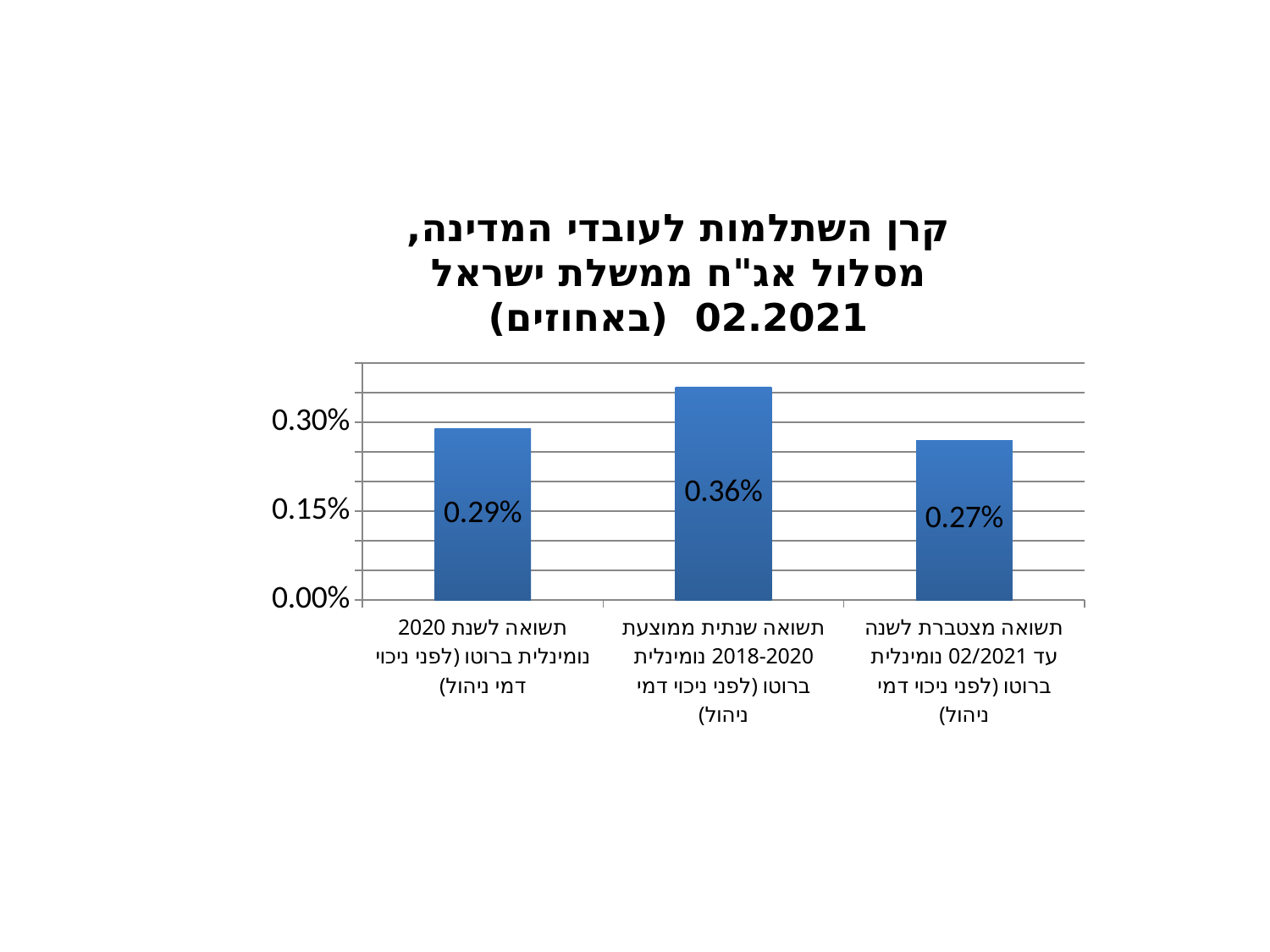
Which category has the highest value? תשואה שנתית ממוצעת 2018-2020 נומינלית ברוטו (לפני ניכוי דמי ניהול) What is the difference between the average annual return 2018-2020 (0.36%) and the return for 2020 (0.29%)? 0.07% What is the value for the category "תשואה שנתית ממוצעת 2018-2020 נומינלית ברוטו (לפני ניכוי דמי ניהול)" (average annual return 2018-2020)? 0.36% Is the value for the average annual return 2018-2020 greater or less than 0.30%? greater What is the value for the category "תשואה לשנת 2020 נומינלית ברוטו (לפני ניכוי דמי ניהול)" (return for 2020)? 0.29% What is the value for the category "תשואה מצטברת לשנה עד 02/2021 נומינלית ברוטו (לפני ניכוי דמי ניהול)" (cumulative return for the year to 02/2021)? 0.27% What kind of chart is shown on the slide? bar chart Which is larger: the return for 2020 or the cumulative return for the year to 02/2021? the return for 2020 (0.29%) How many bars are shown in the chart? 3 Which category has the lowest value? תשואה מצטברת לשנה עד 02/2021 נומינלית ברוטו (לפני ניכוי דמי ניהול) What is the title of the chart? קרן השתלמות לעובדי המדינה, מסלול אג"ח ממשלת ישראל 02.2021 (באחוזים) What is the difference between the return for 2020 (0.29%) and the cumulative return to 02/2021 (0.27%)? 0.02%